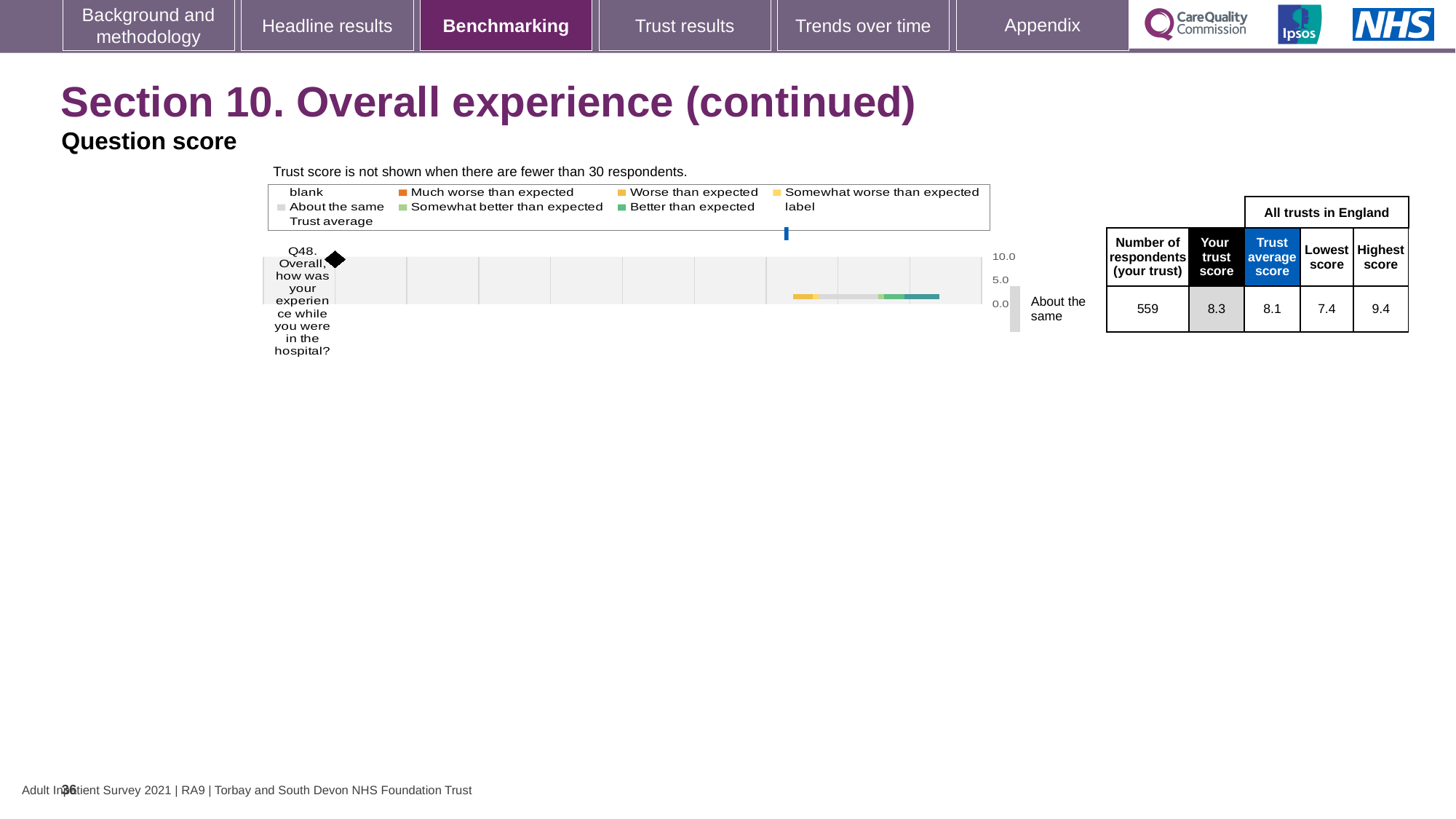
According to the table next to the chart, how many respondents did your trust have for Q48? 559 According to the table next to the chart, what is the lowest score among all trusts in England for Q48? 7.4 According to the table next to the chart, what is the highest score among all trusts in England for Q48? 9.4 According to the table next to the chart, what is the trust average score for Q48? 8.1 Which question number is plotted in the benchmarking chart? Q48 What is the difference between the highest score and the lowest score for Q48 in the table? 2.0 What kind of chart is used to show the Q48 benchmarking result? bar chart What colour does the legend use for 'Much worse than expected'? orange How many entries does the chart legend list? 9 Which is larger for Q48: your trust score or the trust average score? Your trust score According to the table next to the chart, what is your trust score for Q48? 8.3 How many survey questions are plotted in the benchmarking chart? 1